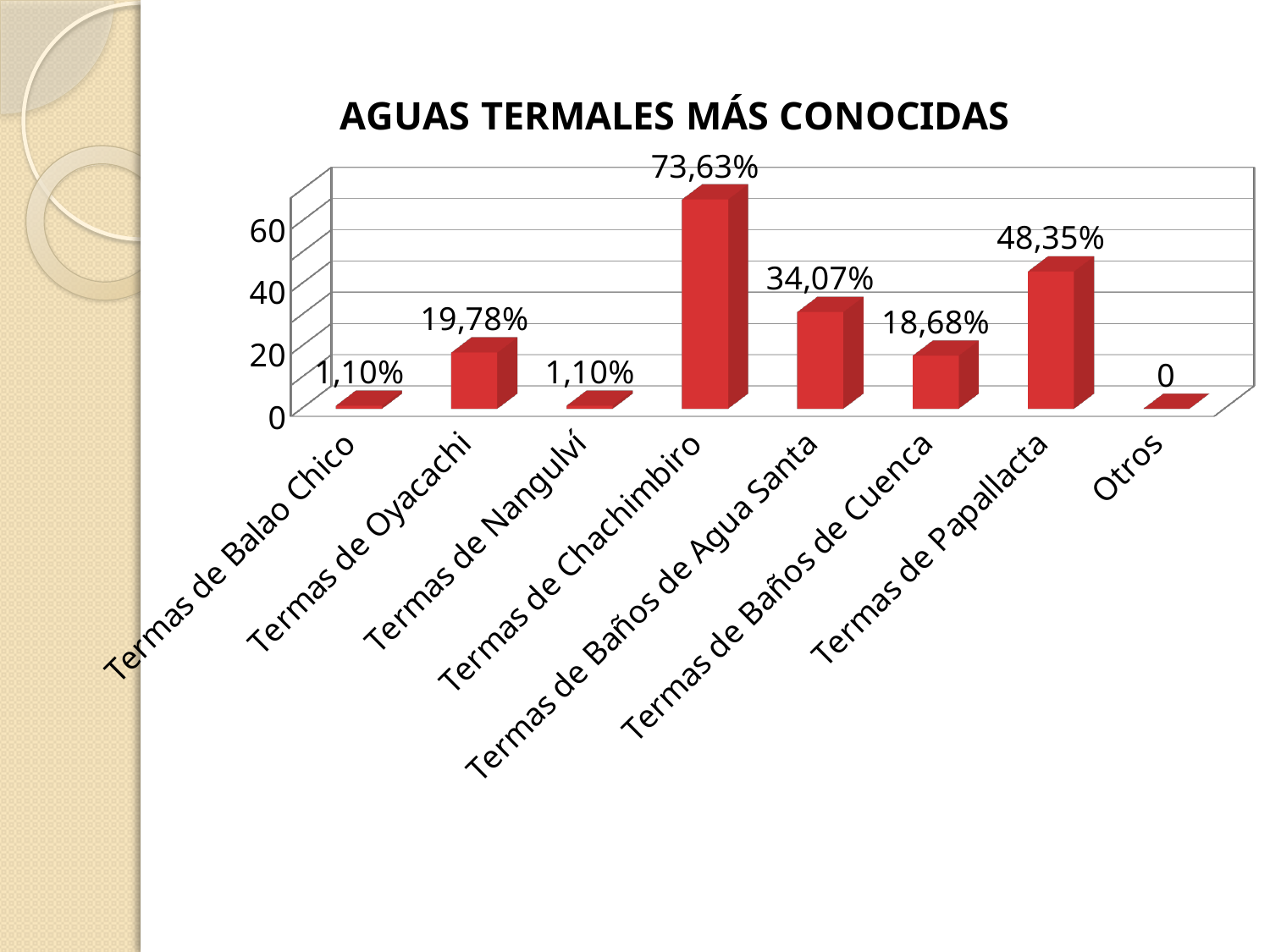
What is the value for Termas de Chachimbiro? 73,63% Which category has the lowest value? Otros What is the difference between the values for Termas de Chachimbiro and Termas de Papallacta? 25,28% Which category has the highest value? Termas de Chachimbiro What is the value for Otros? 0 What is the value for Termas de Oyacachi? 19,78% What is the title of the chart? AGUAS TERMALES MÁS CONOCIDAS How many categories are shown on the x axis? 8 What is the value for Termas de Papallacta? 48,35% Which is larger, the value for Termas de Oyacachi or the value for Termas de Baños de Cuenca? Termas de Oyacachi What is the value for Termas de Baños de Agua Santa? 34,07% What kind of chart is this? Bar chart